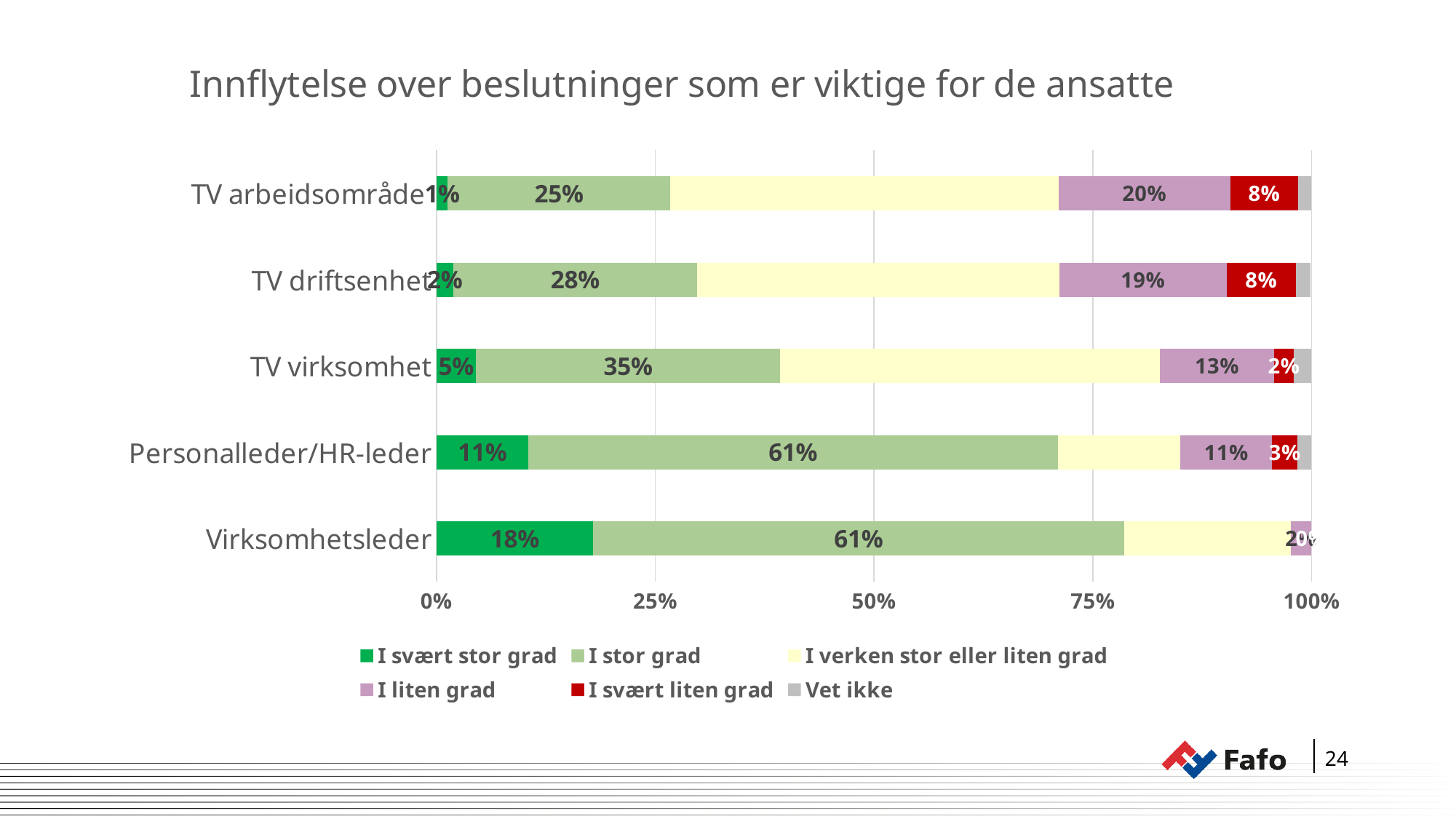
What is the title of the chart? Innflytelse over beslutninger som er viktige for de ansatte What is the difference between the 'I stor grad' values for TV driftsenhet and TV arbeidsområde? 3 percentage points Which category has the lowest value for 'I svært stor grad'? TV arbeidsområde How many categories are shown on the vertical axis of the chart? 5 Is the 'I verken stor eller liten grad' value for TV arbeidsområde greater or less than 25%? greater What is the value of 'I svært stor grad' for Virksomhetsleder? 18% What is the value of 'I liten grad' for TV arbeidsområde? 20% What kind of chart is shown on the slide? Stacked bar chart How many series does the legend list? 6 Which is larger: the 'I svært liten grad' value for TV driftsenhet or for Personalleder/HR-leder? TV driftsenhet Which category has the highest value for 'I svært stor grad'? Virksomhetsleder What is the value of 'I stor grad' for TV virksomhet? 35%